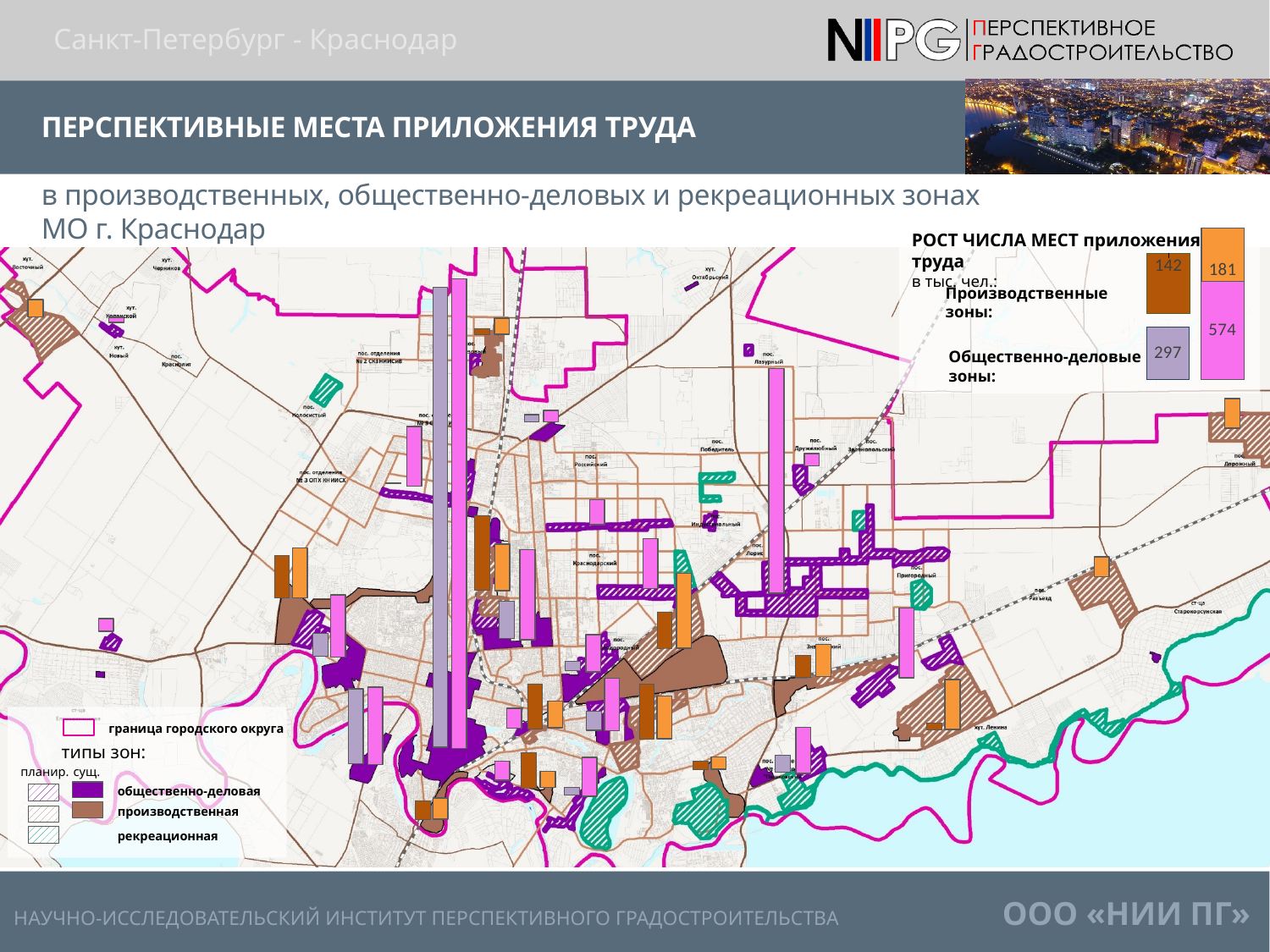
In the chart 'РОСТ ЧИСЛА МЕСТ приложения труда', what is the difference between the two values for Общественно-деловые зоны (574 and 297)? 277 In the chart 'РОСТ ЧИСЛА МЕСТ приложения труда', what value is shown in the lilac segment for Общественно-деловые зоны? 297 In the chart 'РОСТ ЧИСЛА МЕСТ приложения труда', which of the four labelled values is the smallest? 142 In the chart 'РОСТ ЧИСЛА МЕСТ приложения труда', what is the difference between the two values for Производственные зоны (181 and 142)? 39 What kind of chart is 'РОСТ ЧИСЛА МЕСТ приложения труда'? bar chart In the chart 'РОСТ ЧИСЛА МЕСТ приложения труда', which is larger: the pink value for Общественно-деловые зоны or the orange value for Производственные зоны? Общественно-деловые зоны (574) How many zone types are listed in the chart 'РОСТ ЧИСЛА МЕСТ приложения труда'? 2 In the chart 'РОСТ ЧИСЛА МЕСТ приложения труда', what unit are the values given in? тыс. чел. In the chart 'РОСТ ЧИСЛА МЕСТ приложения труда', what value is shown in the pink segment for Общественно-деловые зоны? 574 In the chart 'РОСТ ЧИСЛА МЕСТ приложения труда', what value is shown in the brown segment for Производственные зоны? 142 In the chart 'РОСТ ЧИСЛА МЕСТ приложения труда', what value is shown in the orange segment for Производственные зоны? 181 In the chart 'РОСТ ЧИСЛА МЕСТ приложения труда', which of the four labelled values is the largest? 574